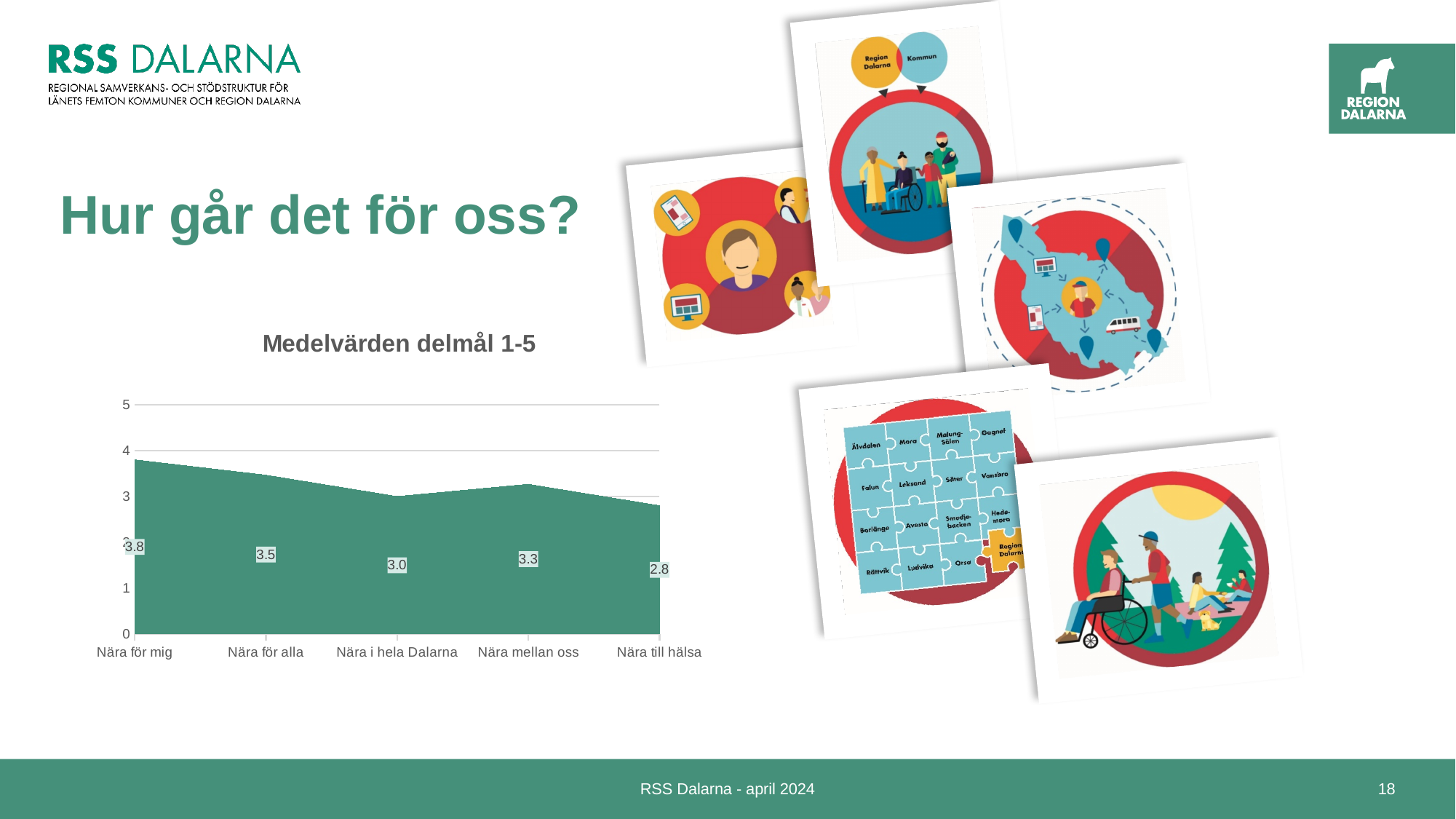
What is the value for Nära för mig? 3.8 Which is larger, the value for Nära för alla or the value for Nära mellan oss? Nära för alla What kind of chart is shown on the slide? Area chart What is the value for Nära till hälsa? 2.8 Is the value for Nära för mig greater or less than 3? greater What is the value for Nära i hela Dalarna? 3.0 Which category has the lowest value? Nära till hälsa What is the difference between the values for Nära för mig and Nära till hälsa? 1.0 What is the title of the chart on the slide? Medelvärden delmål 1-5 What is the difference between the values for Nära mellan oss and Nära i hela Dalarna? 0.3 Which category has the highest value? Nära för mig How many categories are shown on the x axis of the chart? 5